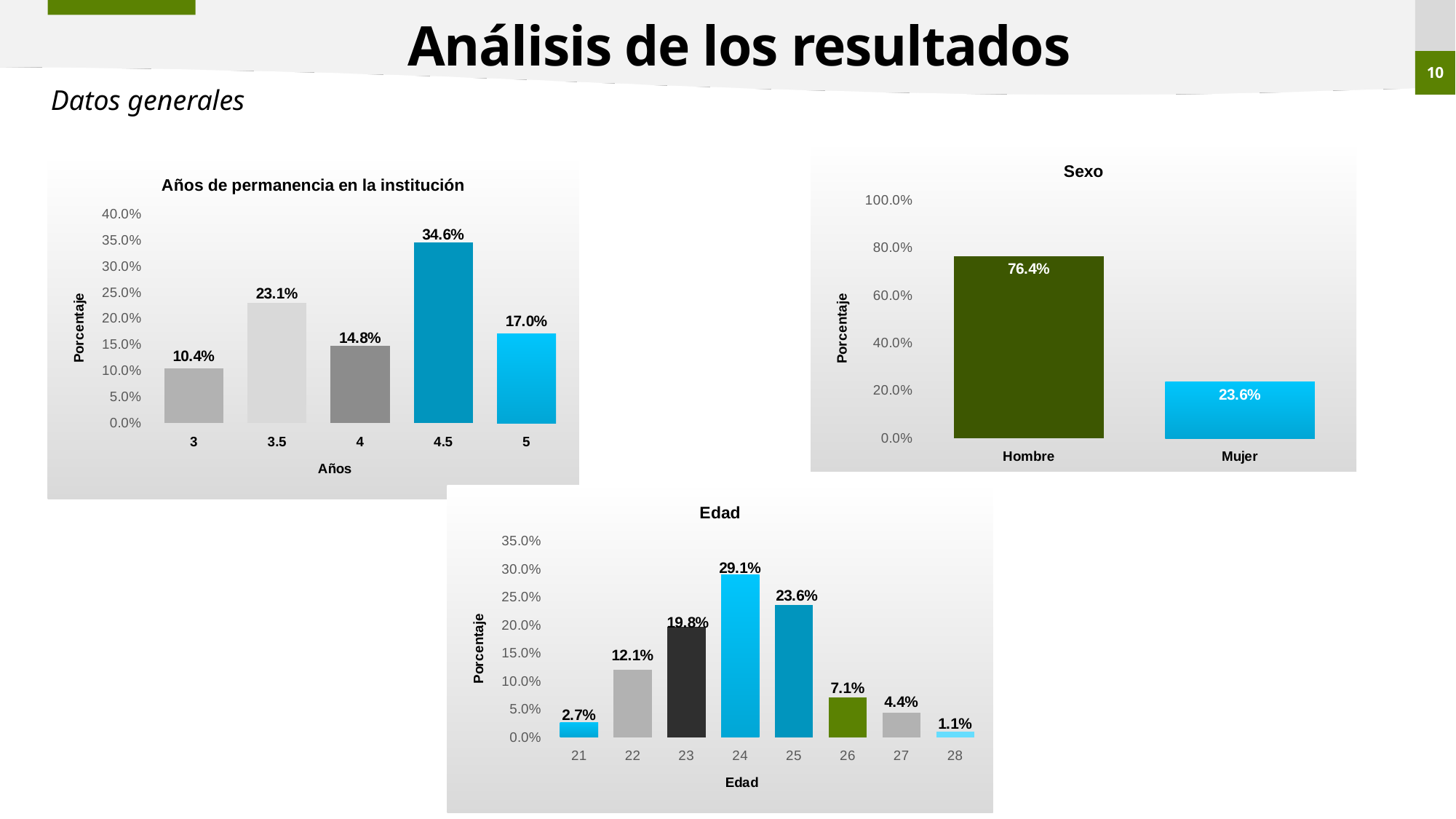
In the 'Años de permanencia en la institución' chart, what is the difference between the values for 3.5 and 4 years? 8.3% In the 'Edad' chart, how many age categories are shown? 8 In the 'Sexo' chart, what is the value for Mujer? 23.6% What kind of chart is the 'Edad' chart? Bar chart In the 'Edad' chart, which age has the lowest value? 28 In the 'Años de permanencia en la institución' chart, which category has the lowest value? 3 In the 'Edad' chart, what is the value for age 23? 19.8% In the 'Años de permanencia en la institución' chart, what is the value for 4.5 years? 34.6% In the 'Años de permanencia en la institución' chart, how many categories are shown on the x axis? 5 In the 'Sexo' chart, which category is higher, Hombre or Mujer? Hombre In the 'Sexo' chart, what is the difference between Hombre and Mujer? 52.8% In the 'Edad' chart, which age has the highest value? 24